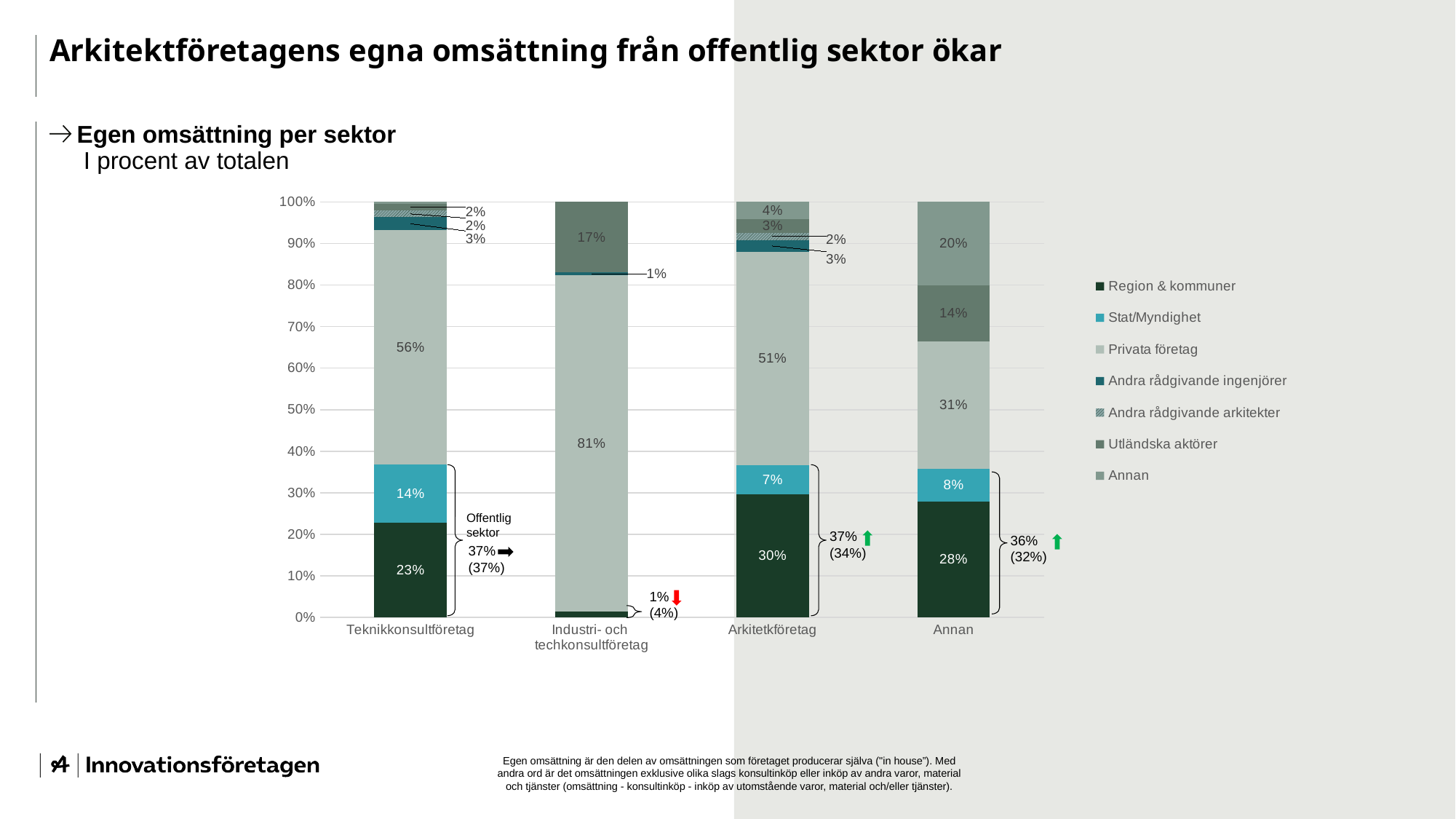
What is the Region & kommuner share for the Annan category? 28% How many percentage points higher is the Privata företag share for Teknikkonsultföretag than for Arkitektföretag? 5 percentage points What percentage does Privata företag account for in the Arkitektföretag bar? 51% Which has a larger Stat/Myndighet share, Arkitektföretag or Annan? Annan Which category has the lowest share for Region & kommuner? Industri- och techkonsultföretag What is the Stat/Myndighet share for Teknikkonsultföretag? 14% What is the Offentlig sektor share annotated for the Arkitektföretag bar? 37% How many series does the legend list? 7 Which category has the highest share for Privata företag? Industri- och techkonsultföretag What kind of chart is shown on the slide? Stacked bar chart How many categories are shown on the x axis? 4 What share do Utländska aktörer have in the Industri- och techkonsultföretag bar? 17%